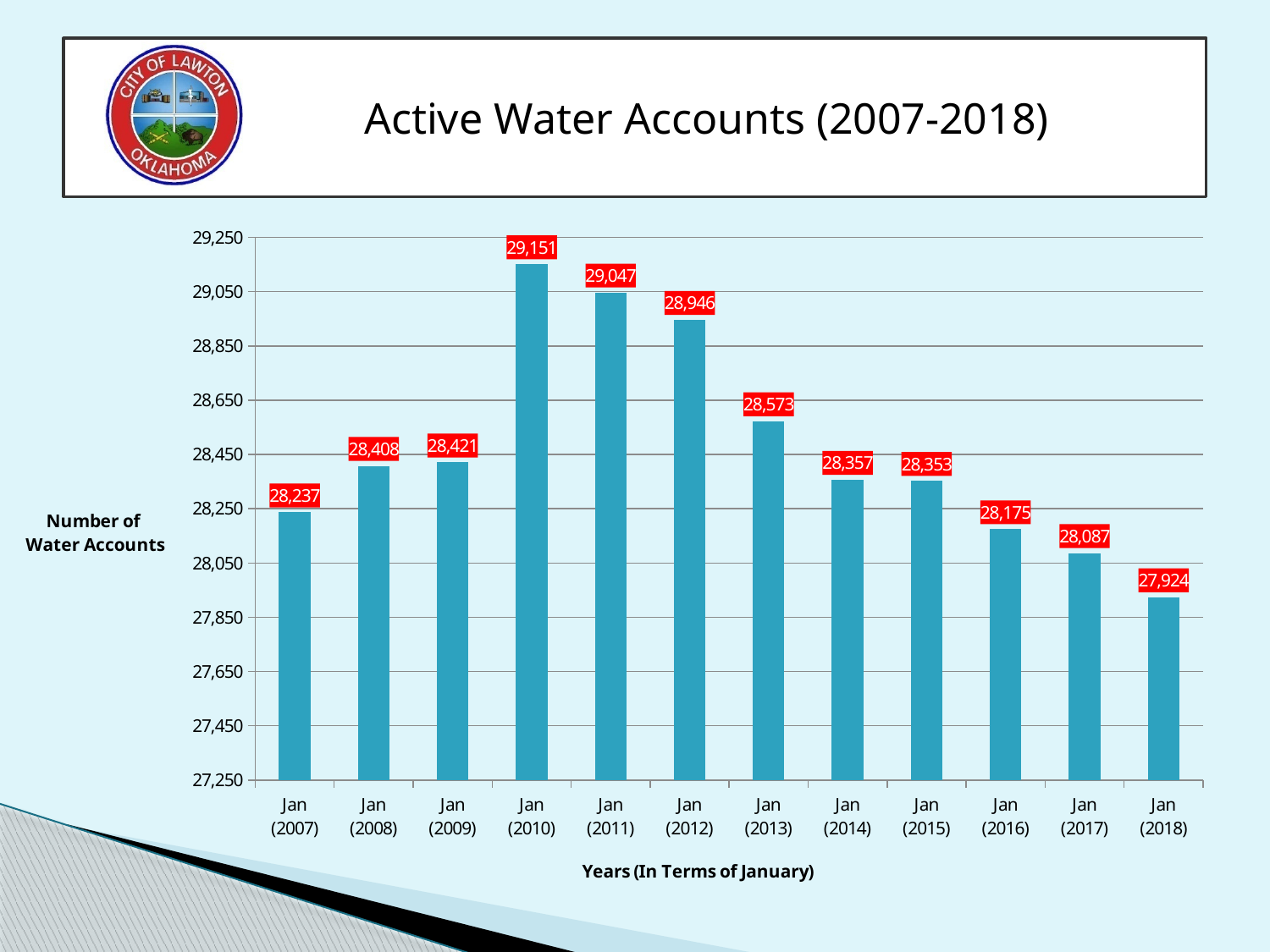
Which year has the highest number of active water accounts? Jan (2010) What is the difference in active water accounts between Jan (2011) and Jan (2012)? 101 Is the value for Jan (2017) greater or less than 28,250? less Which has more active water accounts, Jan (2013) or Jan (2016)? Jan (2013) What is the number of active water accounts in Jan (2018)? 27,924 What is the difference in active water accounts between Jan (2010) and Jan (2018)? 1,227 Which year has the lowest number of active water accounts? Jan (2018) How many years are shown on the chart? 12 What is the number of active water accounts in Jan (2007)? 28,237 What is the number of active water accounts in Jan (2010)? 29,151 Do the values rise or fall from Jan (2012) to Jan (2018)? Fall What kind of chart is shown on the slide? Bar chart